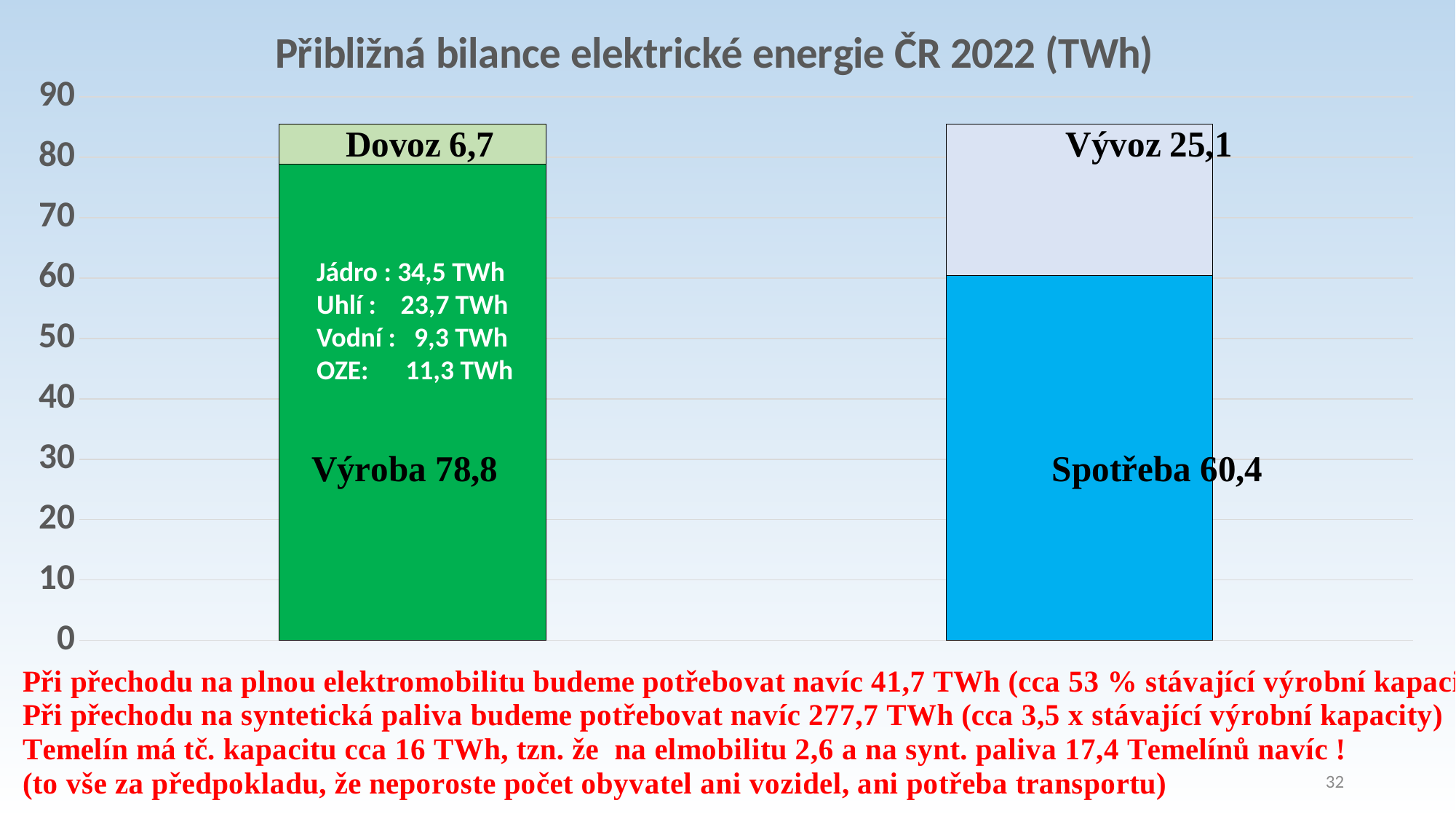
What is the title of the chart? Přibližná bilance elektrické energie ČR 2022 (TWh) What is the value of the Vývoz segment in the right bar? 25,1 Which segment is the smallest of the four shown? Dovoz What is the difference between Výroba and Spotřeba? 18,4 What is the value of the Dovoz segment in the left bar? 6,7 What kind of chart is shown on the slide? Stacked bar chart What is the total of the right stacked bar (Spotřeba plus Vývoz)? 85,5 What is the value of the Spotřeba segment in the right bar? 60,4 What is the difference between Vývoz and Dovoz? 18,4 What is the value of the Výroba segment in the left bar? 78,8 Which is larger, Výroba or Spotřeba? Výroba What is the total of the left stacked bar (Výroba plus Dovoz)? 85,5